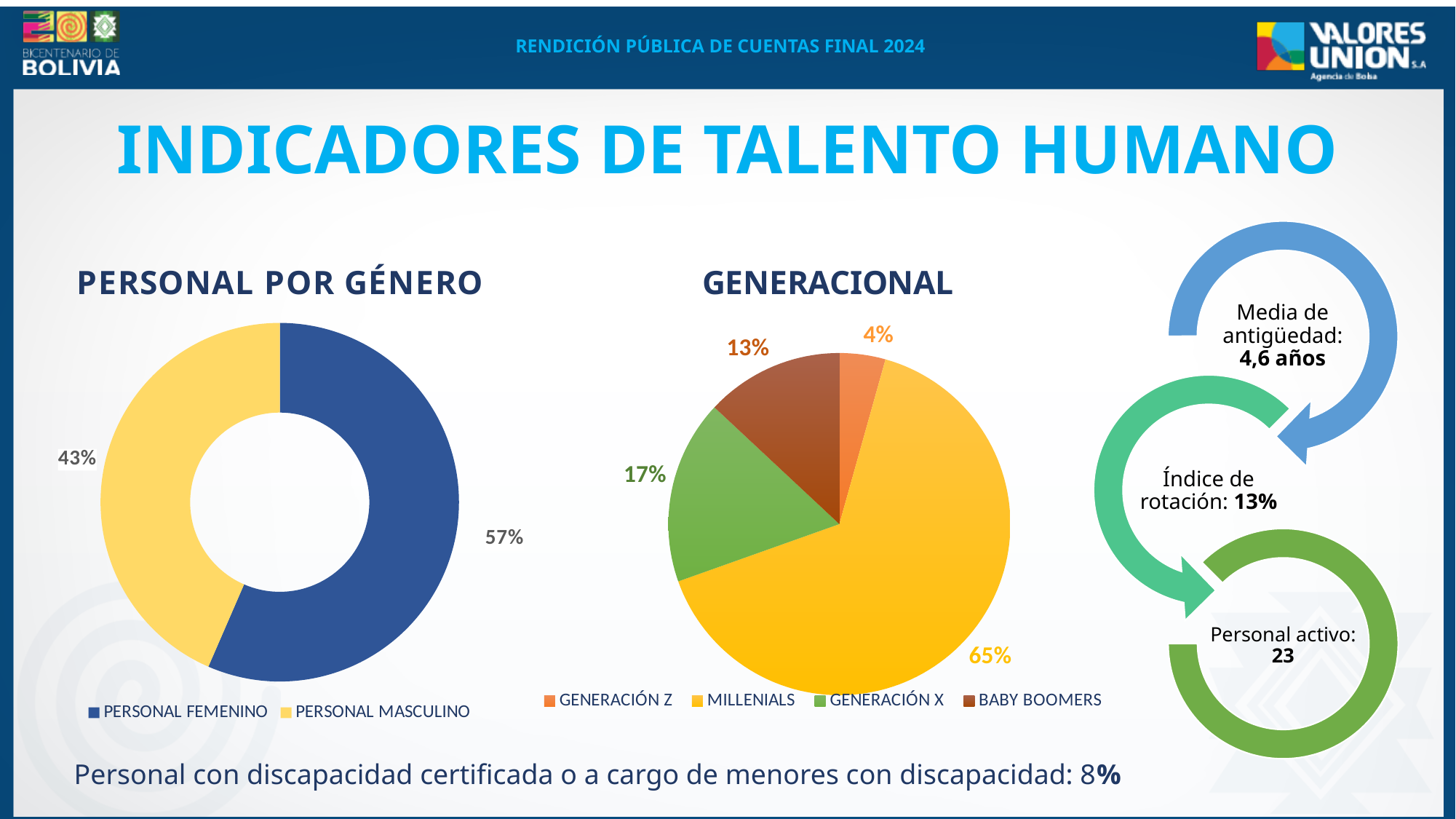
In the GENERACIONAL chart, which generation has the smallest share? GENERACIÓN Z In the GENERACIONAL chart, what percentage is BABY BOOMERS? 13% In the PERSONAL POR GÉNERO chart, what percentage is PERSONAL FEMENINO? 57% In the PERSONAL POR GÉNERO chart, what is the difference in percentage points between PERSONAL FEMENINO and PERSONAL MASCULINO? 14 In the GENERACIONAL chart, what colour represents MILLENIALS? Yellow In the PERSONAL POR GÉNERO chart, which category has the larger share? PERSONAL FEMENINO In the GENERACIONAL chart, what percentage is MILLENIALS? 65% What kind of chart is the PERSONAL POR GÉNERO chart? Doughnut chart In the GENERACIONAL chart, what percentage is GENERACIÓN X? 17% In the GENERACIONAL chart, which is larger, GENERACIÓN X or BABY BOOMERS? GENERACIÓN X In the PERSONAL POR GÉNERO chart, what percentage is PERSONAL MASCULINO? 43% In the GENERACIONAL chart, how many categories does the legend list? 4